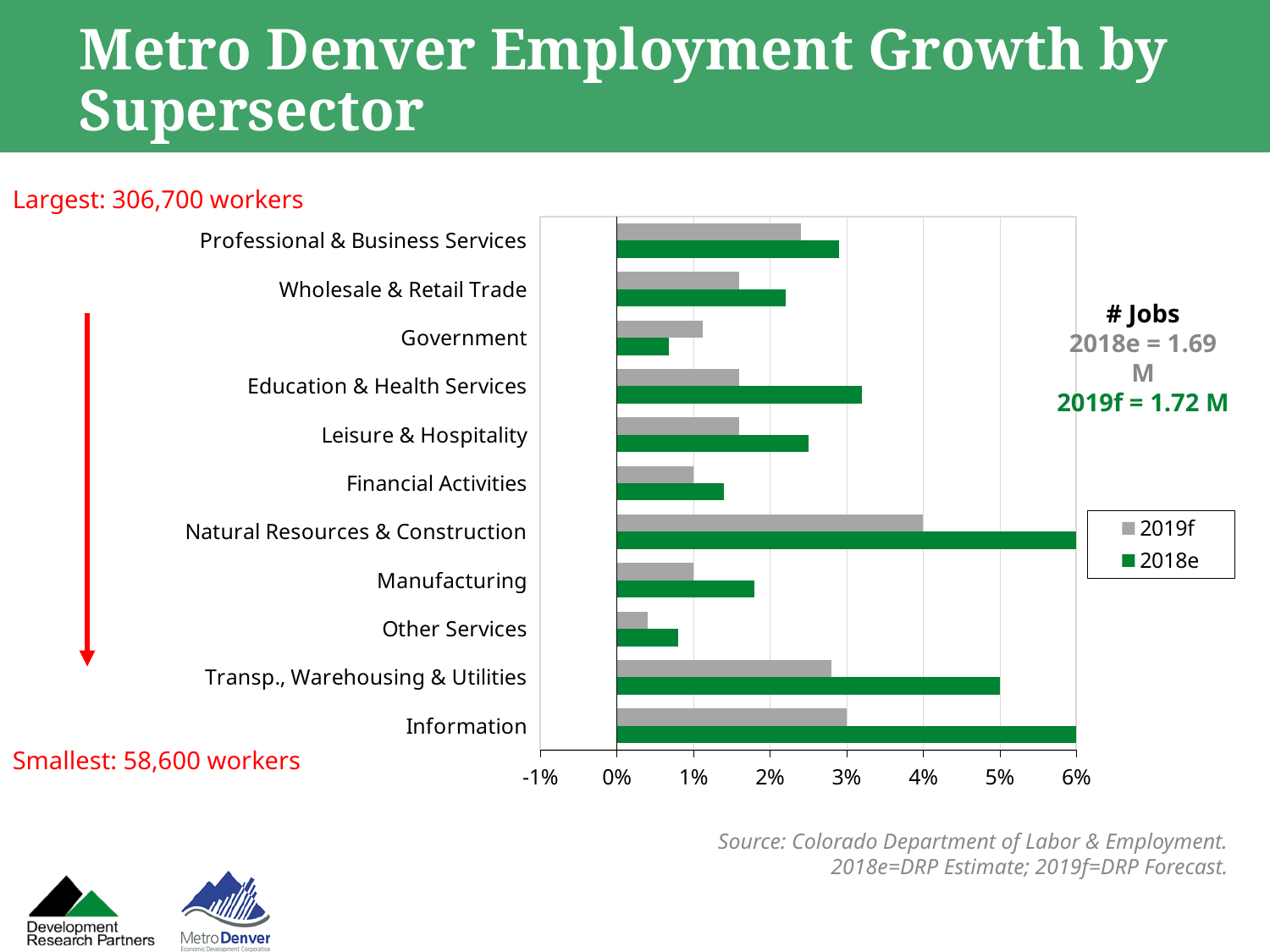
Is the 2018e value for Natural Resources & Construction greater or less than 5%? greater Is the 2019f value for Government greater or less than 2%? less Is the 2018e value for Education & Health Services greater or less than 3%? greater What kind of chart is shown on the slide? bar chart Which colour represents the 2018e series in the chart? green Which is larger: the 2018e value for Education & Health Services or the 2018e value for Leisure & Hospitality? Education & Health Services For Government, which is larger: the 2019f value or the 2018e value? 2019f How many series does the chart legend list? 2 Which supersector has the highest 2019f value? Natural Resources & Construction How many supersector categories are plotted on the chart? 11 What is the title of the slide's chart? Metro Denver Employment Growth by Supersector Which supersector has the lowest 2019f value? Other Services